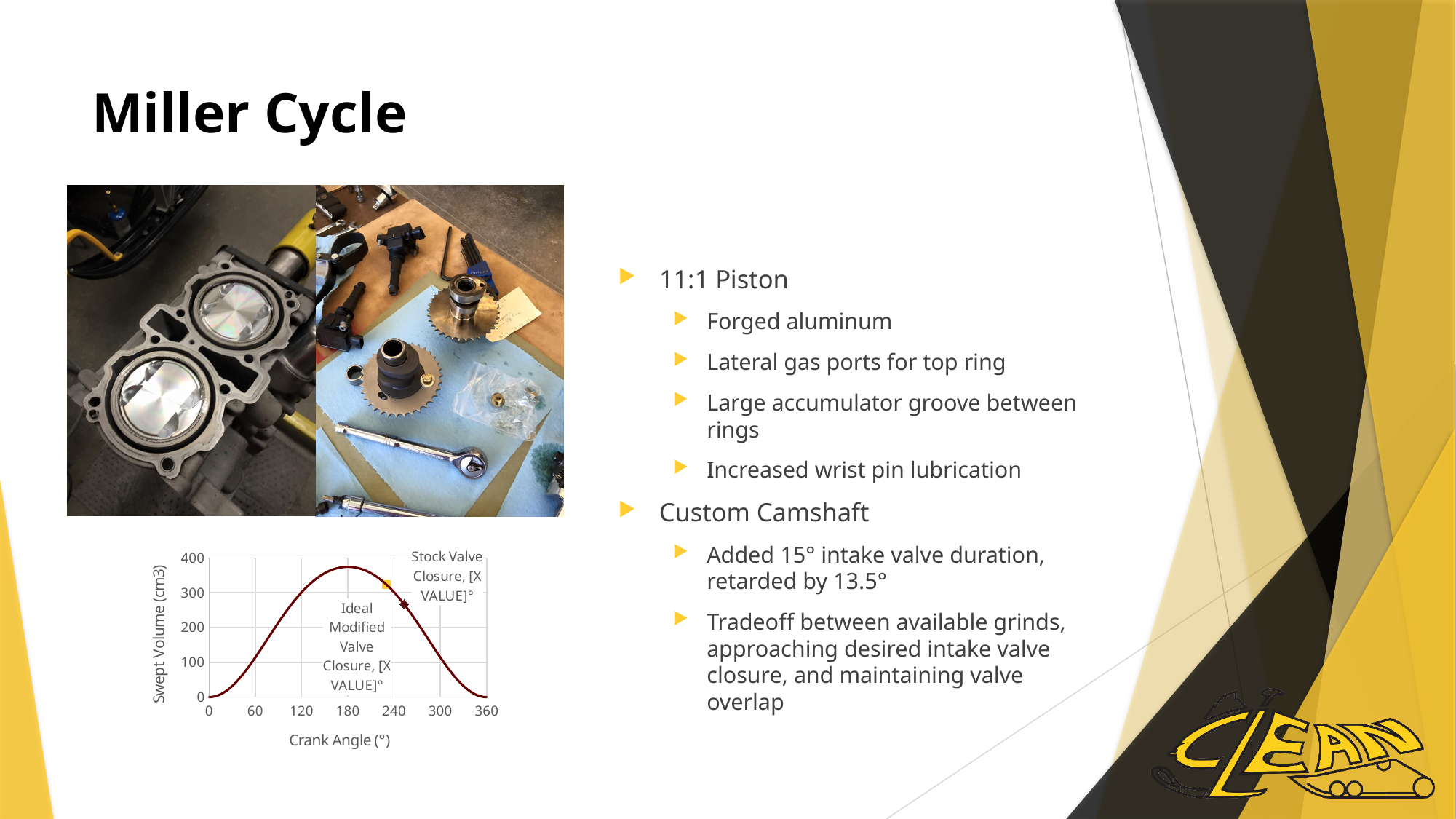
What is the swept volume at a crank angle of 0°? 0 What is the title of the y axis of the chart? Swept Volume (cm3) What kind of chart is shown at the bottom left of the slide? line chart At which crank angle does the swept volume reach its maximum? 180 Is the swept volume at a crank angle of 180° greater or less than 300? greater What is the title of the x axis of the chart? Crank Angle (°) Is the swept volume at a crank angle of 300° greater or less than 200? less What is the swept volume at a crank angle of 360°? 0 Which marked point has the higher swept volume, Stock Valve Closure or Ideal Modified Valve Closure? Stock Valve Closure How many tick labels are shown on the x axis of the chart? 7 How does the swept volume change as the crank angle increases from 0° to 180°? rises Is the swept volume at a crank angle of 60° greater or less than 200? less